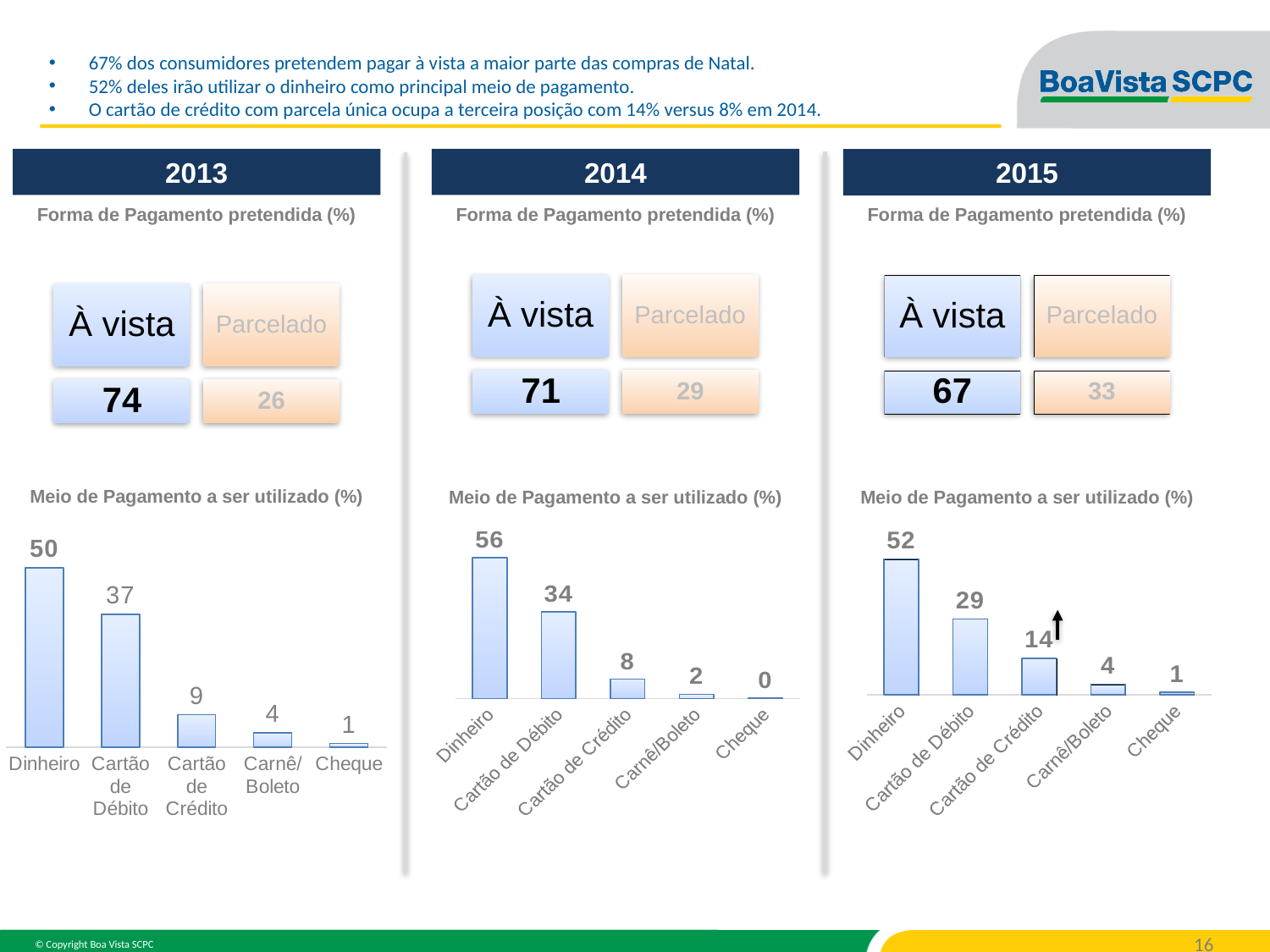
In the 2014 chart 'Meio de Pagamento a ser utilizado (%)', which is larger, Cartão de Crédito or Carnê/Boleto? Cartão de Crédito In the 2014 chart 'Meio de Pagamento a ser utilizado (%)', do the values rise or fall from Dinheiro to Cheque? Fall In the 2015 chart 'Meio de Pagamento a ser utilizado (%)', what is the difference between Cartão de Débito and Cartão de Crédito? 15 How many categories are shown in the 2013 chart 'Meio de Pagamento a ser utilizado (%)'? 5 In the 2015 chart 'Meio de Pagamento a ser utilizado (%)', which category has the highest value? Dinheiro In the 2014 chart 'Meio de Pagamento a ser utilizado (%)', which category has the lowest value? Cheque In the 2015 chart 'Meio de Pagamento a ser utilizado (%)', what is the value for Cartão de Crédito? 14 In the 2014 chart 'Meio de Pagamento a ser utilizado (%)', what is the value for Cartão de Débito? 34 What type of chart is the 2015 chart 'Meio de Pagamento a ser utilizado (%)'? Bar chart In the 2013 chart 'Meio de Pagamento a ser utilizado (%)', what is the value for Dinheiro? 50 In the 2013 chart 'Meio de Pagamento a ser utilizado (%)', what is the difference between Dinheiro and Cartão de Débito? 13 In the 2015 chart 'Meio de Pagamento a ser utilizado (%)', what is the value for Carnê/Boleto? 4